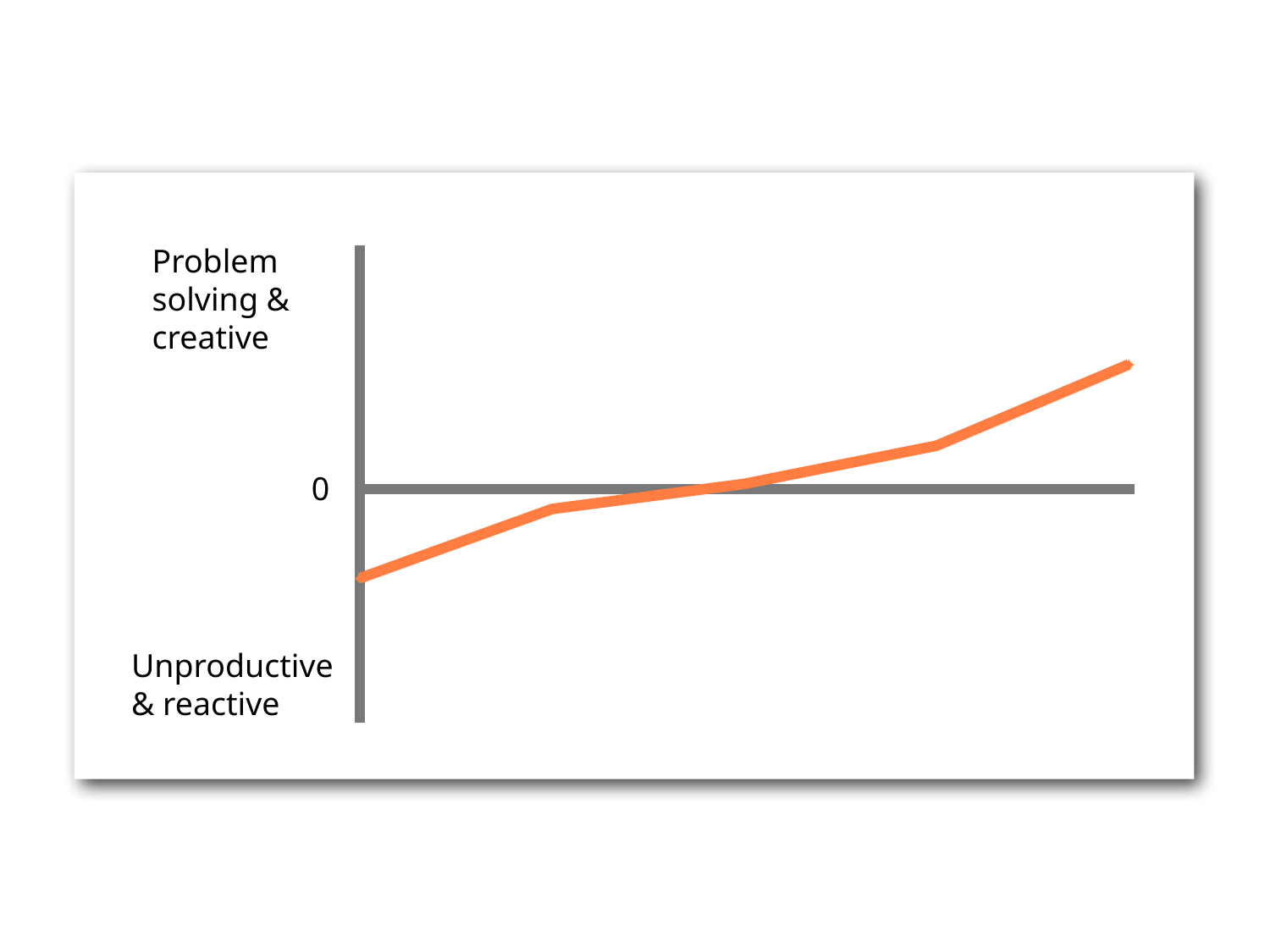
Does the orange line rise or fall from left to right? Rises Which end of the line is higher, the left end or the right end? The right end How many lines are plotted on the chart? 1 What kind of chart is shown on the slide? Line chart Is the value at the left end of the orange line greater or less than 0? less What label appears at the bottom of the vertical axis? Unproductive & reactive Is the value at the right end of the orange line greater or less than 0? greater What label appears at the top of the vertical axis? Problem solving & creative What value is marked where the horizontal axis meets the vertical axis? 0